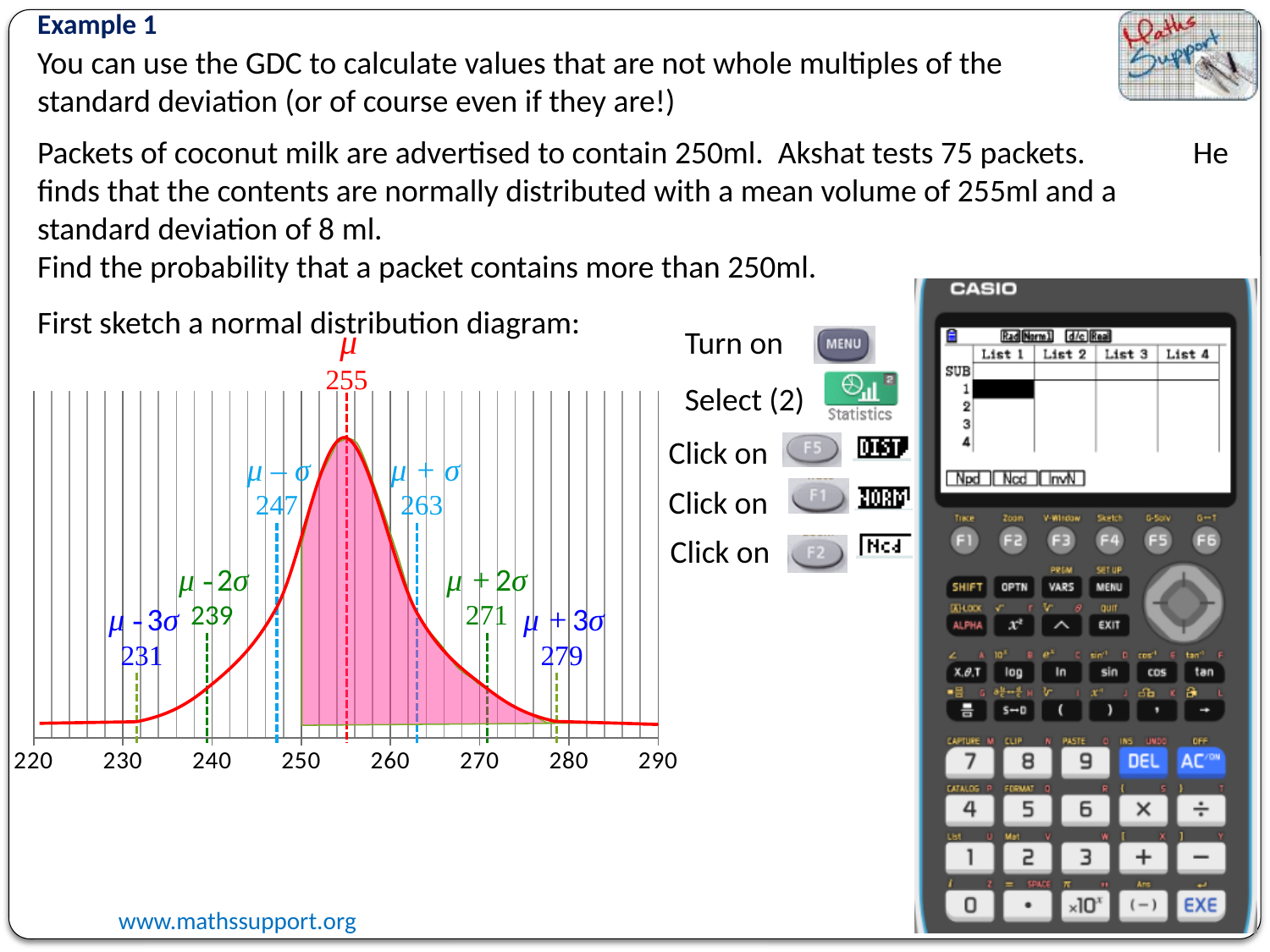
At what x-axis value does the pink shaded region under the curve begin? 250 What value is labelled at μ + σ on the normal distribution diagram? 263 Which is larger on the diagram, the value at μ + 2σ or the value at μ + 3σ? μ + 3σ What value is labelled at μ − σ on the normal distribution diagram? 247 What value is labelled at the mean μ on the normal distribution diagram? 255 What are the lowest and highest values shown on the x axis of the normal distribution diagram? 220 and 290 What is the difference between the values labelled at μ + σ and μ − σ on the diagram? 16 How many labelled points (μ and the σ multiples) are marked on the normal distribution diagram? 7 What value is labelled at μ + 3σ on the normal distribution diagram? 279 What is the difference between the values labelled at μ + 3σ and μ − 3σ on the diagram? 48 Which labelled point on the diagram has the lowest value? μ - 3σ What value is labelled at μ − 2σ on the normal distribution diagram? 239